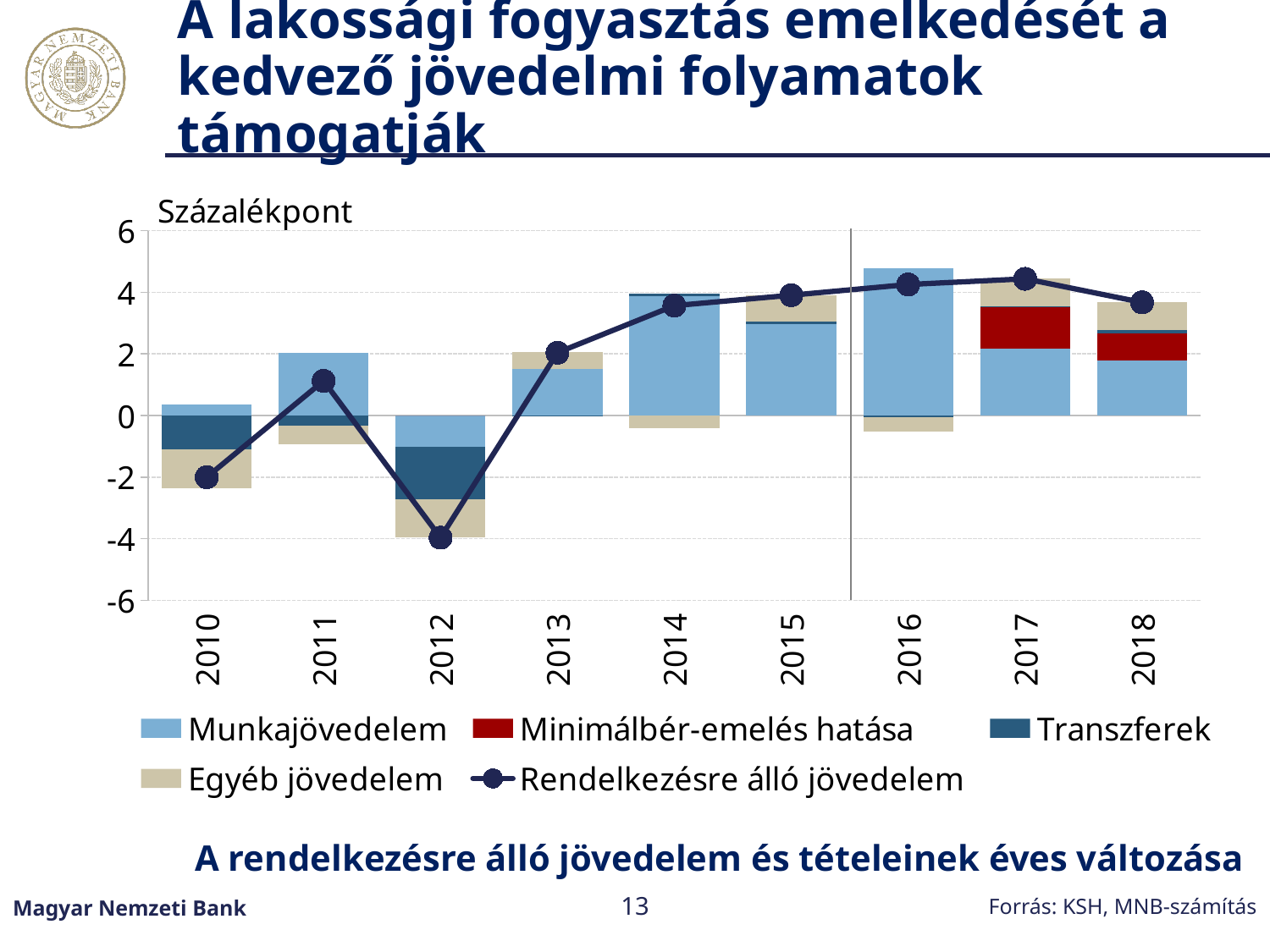
Is the value of the Rendelkezésre álló jövedelem line for 2014 greater or less than 2? greater What unit is shown above the y axis of the chart? Százalékpont In how many years does the Minimálbér-emelés hatása series appear as a bar segment? 2 What kind of chart is shown on the slide? bar chart (stacked bars with a line) In which year is the Rendelkezésre álló jövedelem line at its highest? 2017 How many series does the chart's legend list? 5 Is the value of the Rendelkezésre álló jövedelem line for 2012 greater or less than -2? less In which year is the Rendelkezésre álló jövedelem line at its lowest? 2012 How many years are shown on the x axis of the chart? 9 Is the value of the Rendelkezésre álló jövedelem line for 2017 greater or less than 4? greater Which year has the higher value on the Rendelkezésre álló jövedelem line, 2010 or 2011? 2011 Does the Rendelkezésre álló jövedelem line rise or fall from 2012 to 2017? rise